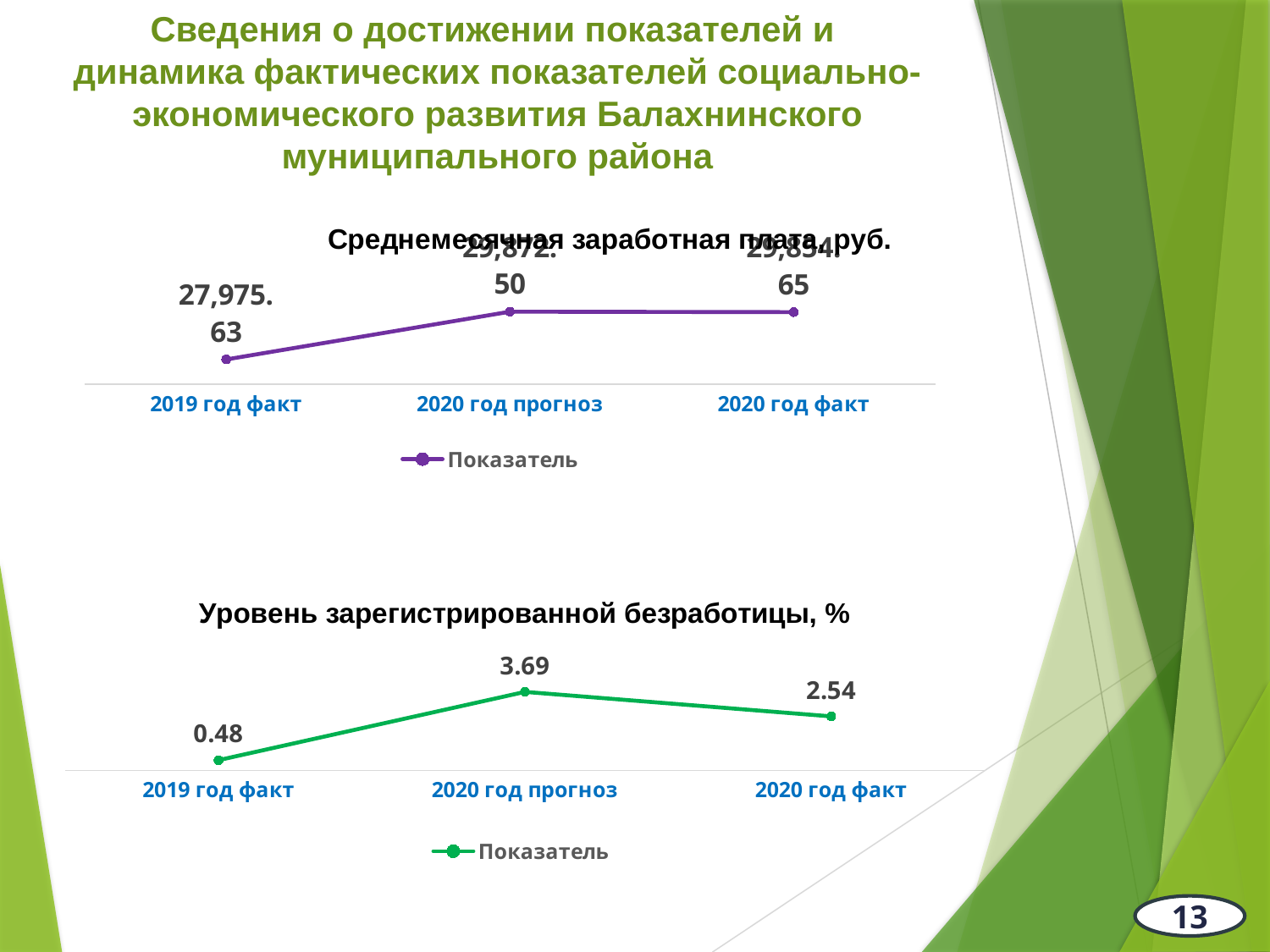
In the chart 'Уровень зарегистрированной безработицы, %', what is the difference between the values for 2020 год прогноз and 2019 год факт? 3.21 In the chart 'Уровень зарегистрированной безработицы, %', what is the value for 2019 год факт? 0.48 In the chart 'Среднемесячная заработная плата, руб.', which category has the lowest value? 2019 год факт In the chart 'Уровень зарегистрированной безработицы, %', what is the value for 2020 год факт? 2.54 How many categories are shown on the x axis of the chart 'Уровень зарегистрированной безработицы, %'? 3 In the chart 'Среднемесячная заработная плата, руб.', what is the value for 2019 год факт? 27,975.63 In the chart 'Среднемесячная заработная плата, руб.', which is larger: the value for 2019 год факт or the value for 2020 год факт? 2020 год факт In the chart 'Уровень зарегистрированной безработицы, %', what is the difference between the values for 2020 год прогноз and 2020 год факт? 1.15 In the chart 'Уровень зарегистрированной безработицы, %', which category has the highest value? 2020 год прогноз In the chart 'Уровень зарегистрированной безработицы, %', what is the value for 2020 год прогноз? 3.69 In the chart 'Уровень зарегистрированной безработицы, %', which category has the lowest value? 2019 год факт What kind of chart is 'Среднемесячная заработная плата, руб.'? line chart